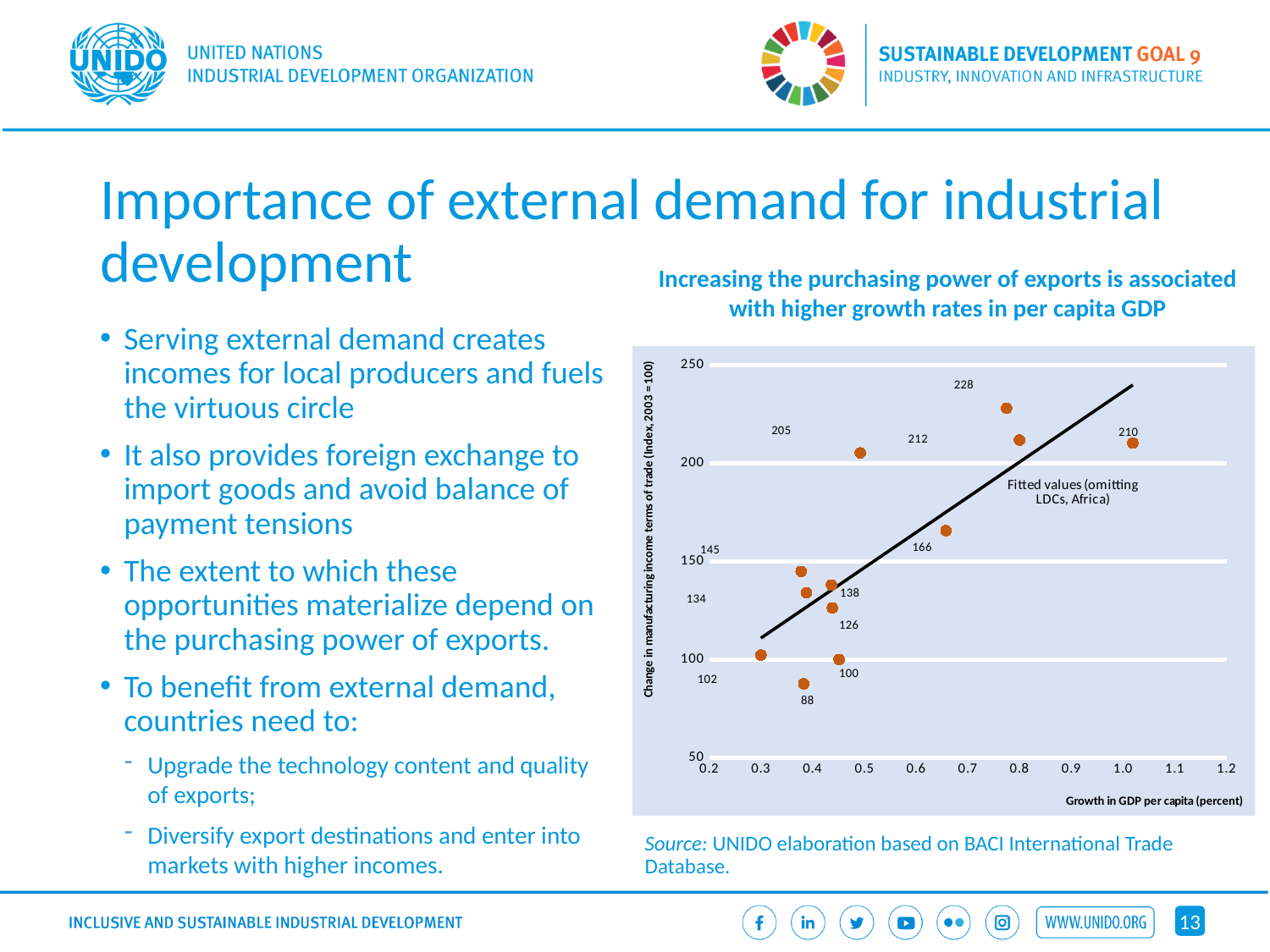
Which is larger, the point labeled 205 or the point labeled 166? 205 What is the lowest data label value shown on the chart? 88 How many data points are plotted on the chart? 12 What does the text next to the black line on the chart say? Fitted values (omitting LDCs, Africa) What is the label of the x axis? Growth in GDP per capita (percent) What is the data label of the leftmost point on the chart (at about 0.3 on the x axis)? 102 What is the data label of the rightmost point on the chart (at about 1.0 on the x axis)? 210 Is the value of the point labeled 88 greater or less than 100? less What is the difference between the highest labeled value (228) and the lowest labeled value (88)? 140 What kind of chart is shown on the slide? scatter chart What is the highest data label value shown on the chart? 228 Does the fitted line rise or fall as growth in GDP per capita increases? rises